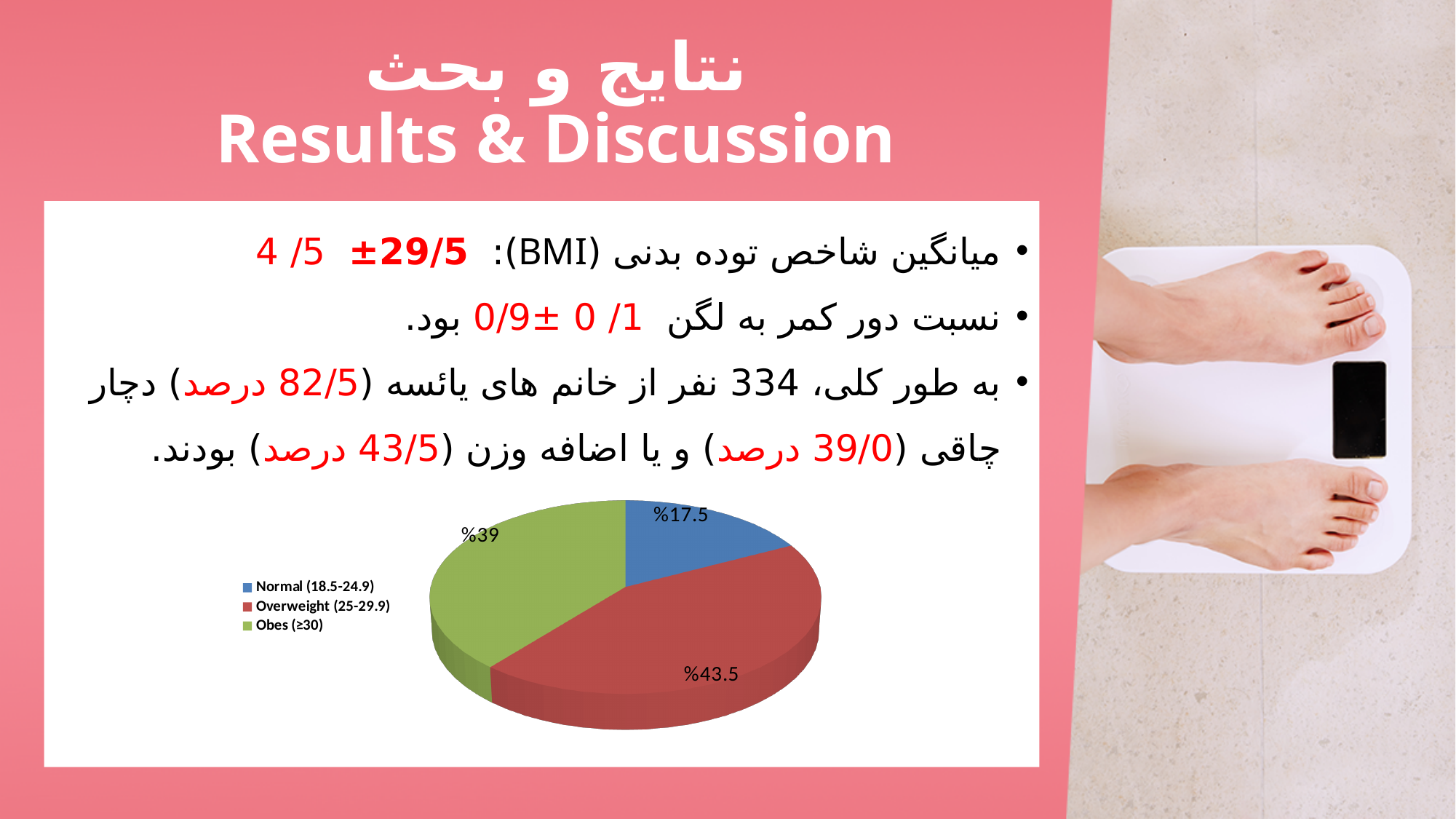
What is the difference between the Overweight (25-29.9) and Obes (≥30) values in the pie chart? 4.5 Which is larger in the pie chart, the Obes (≥30) slice or the Normal (18.5-24.9) slice? Obes (≥30) What colour is the Overweight (25-29.9) slice in the pie chart? red What is the value shown for the Normal (18.5-24.9) slice of the pie chart? %17.5 What kind of chart is shown on the slide? pie chart How many slices does the pie chart have? 3 Which category has the largest slice in the pie chart? Overweight (25-29.9) Which category has the smallest slice in the pie chart? Normal (18.5-24.9) Which category does the green slice of the pie chart represent? Obes (≥30) What is the value shown for the Overweight (25-29.9) slice of the pie chart? %43.5 What is the difference between the Obes (≥30) and Normal (18.5-24.9) values in the pie chart? 21.5 What is the value shown for the Obes (≥30) slice of the pie chart? %39